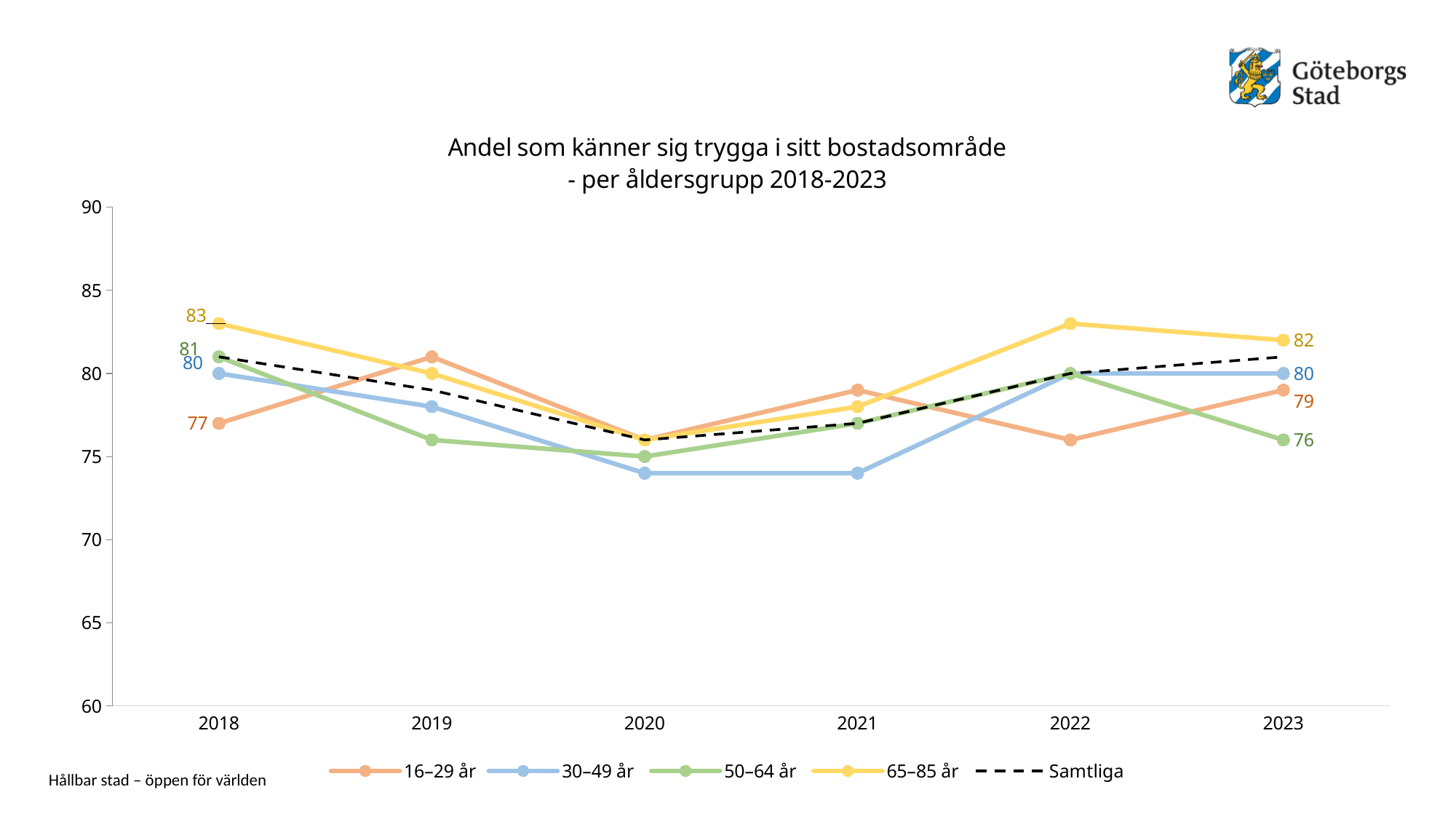
What is the value for 65–85 år in 2018? 83 Which age group has the highest value in 2018? 65–85 år What type of chart is shown on the slide? line chart How many series does the legend list? 5 Which is larger in 2023: the value for 30–49 år or the value for 50–64 år? 30–49 år Between 2018 and 2023, did the value for 50–64 år rise or fall? fall What is the difference between the 65–85 år value and the 16–29 år value in 2018? 6 What is the value for 50–64 år in 2023? 76 Is the value for 30–49 år in 2020 greater or less than 80? less Which age group has the lowest value in 2023? 50–64 år How many years are shown on the x axis? 6 What is the value for 16–29 år in 2023? 79